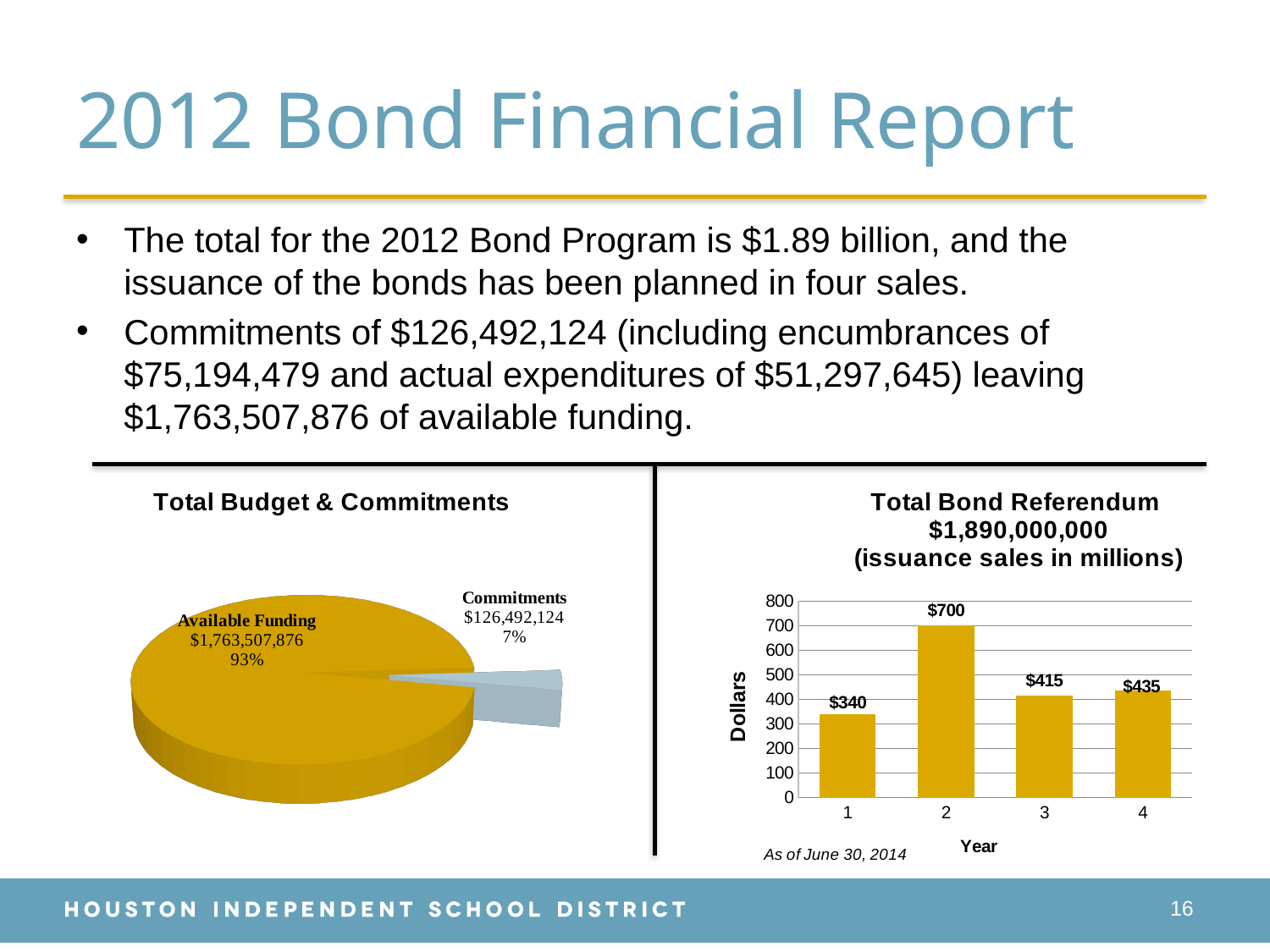
In the Total Bond Referendum chart, how many years are shown on the x axis? 4 What is the label on the y axis of the Total Bond Referendum chart? Dollars In the Total Budget & Commitments chart, what share of the pie is Available Funding? 93% In the Total Bond Referendum chart, what is the difference between the values for Year 2 and Year 1? $360 In the Total Bond Referendum chart, which year has the highest value? 2 In the Total Bond Referendum chart, what is the value for Year 2? $700 In the Total Bond Referendum chart, what is the value for Year 1? $340 In the Total Budget & Commitments chart, what is the value for Commitments? $126,492,124 What kind of chart is the Total Budget & Commitments chart? Pie chart In the Total Bond Referendum chart, which year has the lowest value? 1 In the Total Bond Referendum chart, which is larger, the value for Year 3 or Year 4? Year 4 What kind of chart is the Total Bond Referendum chart? Bar chart